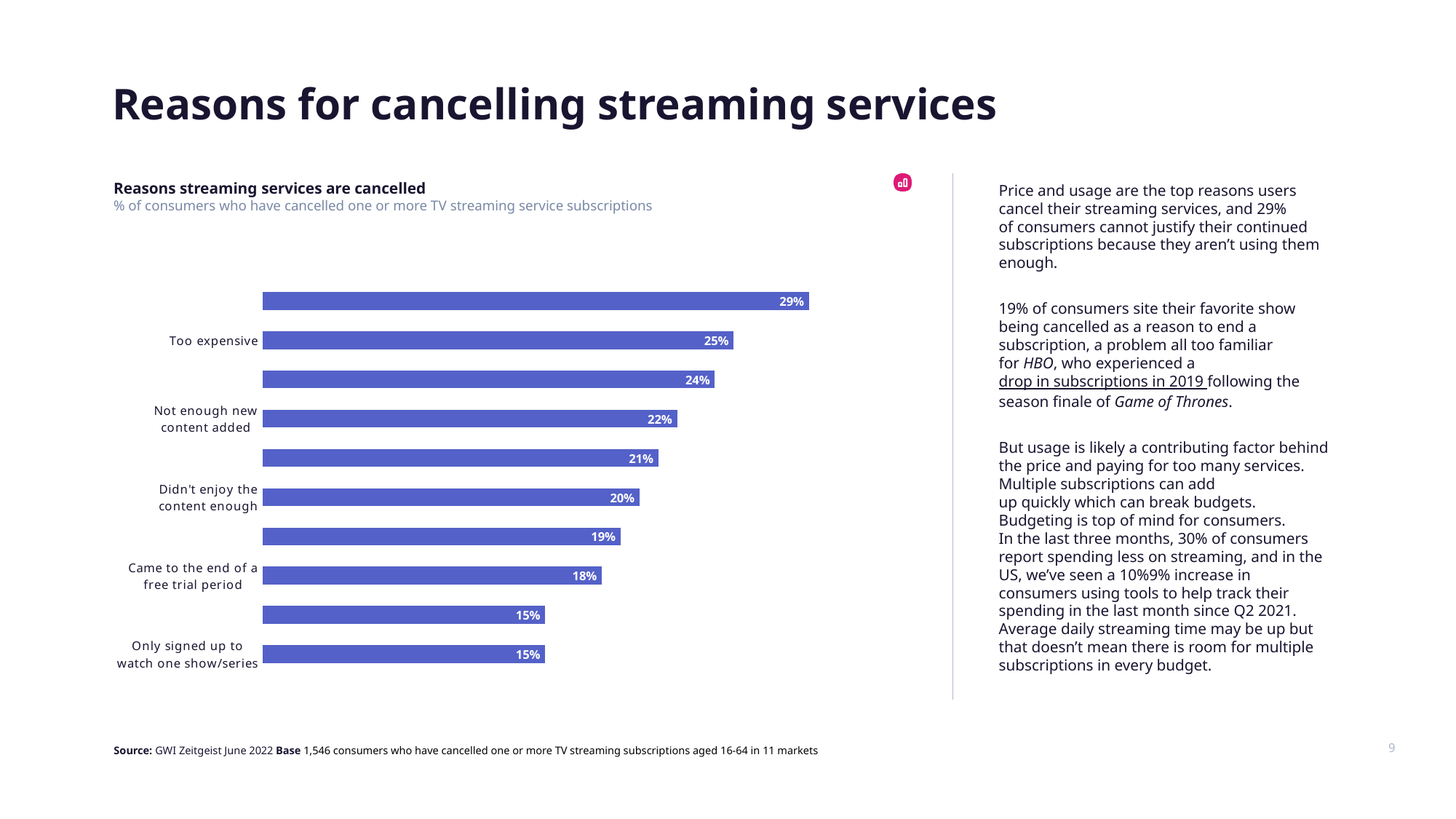
What is the value for "Came to the end of a free trial period"? 18% What is the difference between the values for "Too expensive" and "Only signed up to watch one show/series"? 10% What is the lowest value shown on the chart? 15% Which is larger, the value for "Not enough new content added" or the value for "Came to the end of a free trial period"? Not enough new content added What kind of chart is shown on the slide? bar chart How many bars are plotted on the chart? 10 What is the value for "Too expensive"? 25% What is the highest value shown on the chart? 29% What is the value for "Only signed up to watch one show/series"? 15% What is the value for "Not enough new content added"? 22% What is the title of the chart? Reasons streaming services are cancelled What is the value for "Didn't enjoy the content enough"? 20%